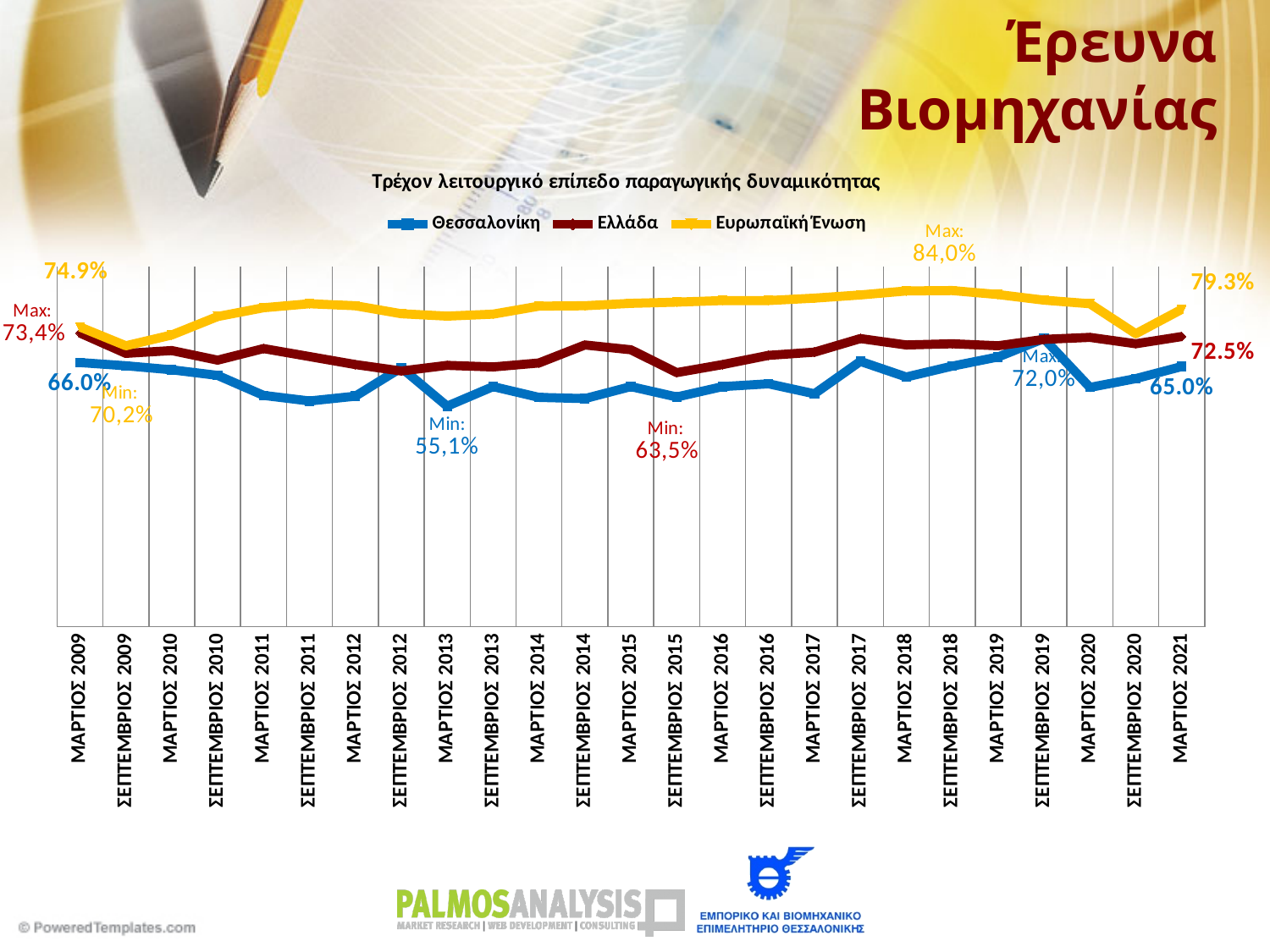
How many time points are shown on the x axis? 25 What is the value for Ευρωπαϊκή Ένωση at ΜΑΡΤΙΟΣ 2021? 79.3% What is the minimum value labelled for the Ελλάδα series? 63,5% Which series has the highest value at ΜΑΡΤΙΟΣ 2021: Θεσσαλονίκη, Ελλάδα or Ευρωπαϊκή Ένωση? Ευρωπαϊκή Ένωση What is the minimum value labelled for the Θεσσαλονίκη series? 55,1% What is the difference between the Ευρωπαϊκή Ένωση value and the Θεσσαλονίκη value at ΜΑΡΤΙΟΣ 2021? 14.3% What is the title of the chart? Τρέχον λειτουργικό επίπεδο παραγωγικής δυναμικότητας What is the maximum value labelled for the Ευρωπαϊκή Ένωση series? 84,0% What is the value for Ελλάδα at ΜΑΡΤΙΟΣ 2021? 72.5% How many series does the legend list? 3 What is the value for Θεσσαλονίκη at ΜΑΡΤΙΟΣ 2009? 66.0% What type of chart is shown on the slide? Line chart